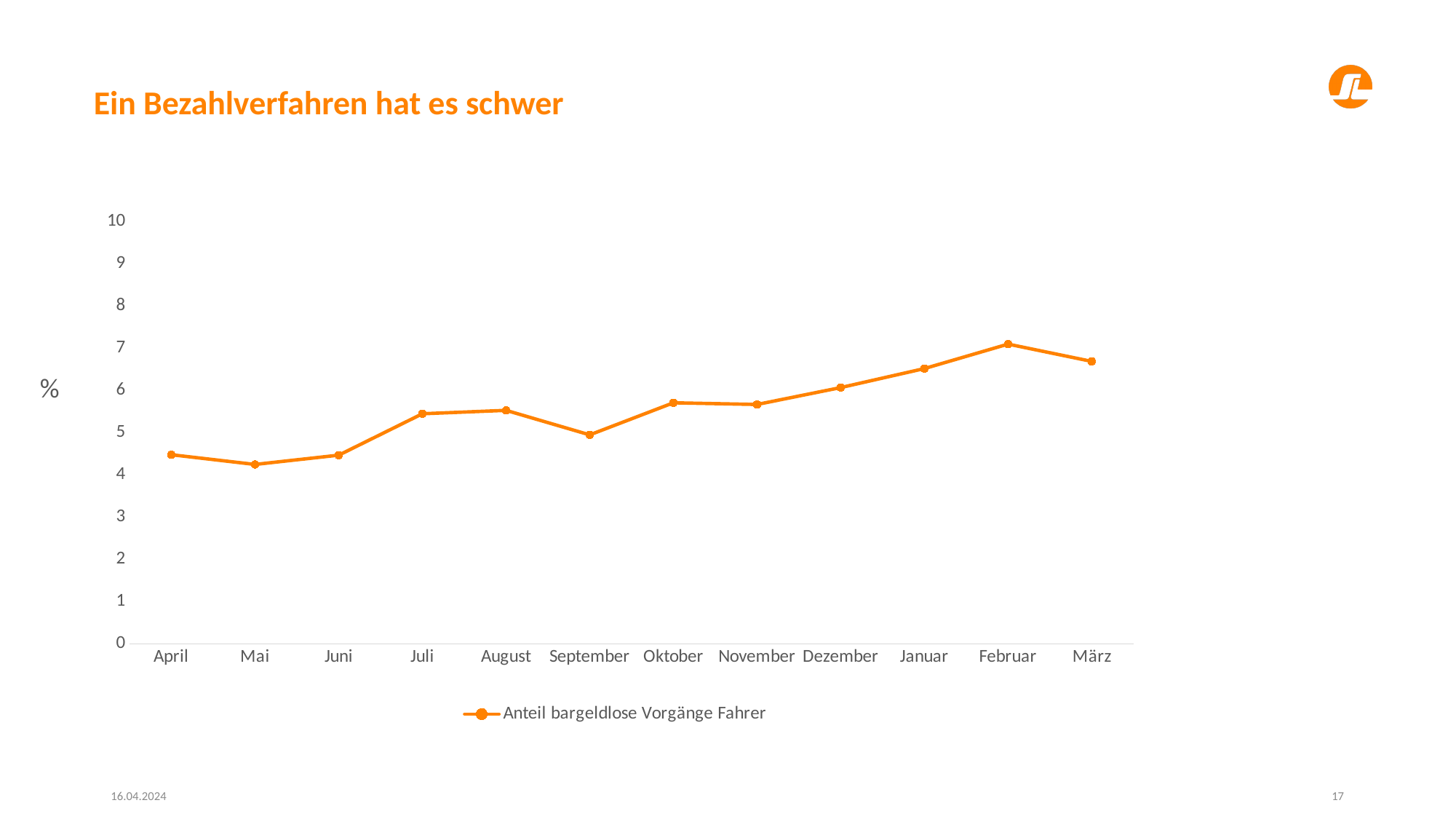
Is the value for Juli greater or less than 5? greater In which month is the share of cashless transactions lowest? Mai Is the value for Mai greater or less than 5? less What is the name of the series shown in the legend? Anteil bargeldlose Vorgänge Fahrer Is the value for März greater or less than 6? greater How many months are plotted on the x axis? 12 Which month has the larger value, Januar or Juli? Januar In which month is the share of cashless transactions (Anteil bargeldlose Vorgänge Fahrer) highest? Februar Overall, do the values rise or fall from April to März? rise How many series does the legend list? 1 What kind of chart is shown on the slide? line chart